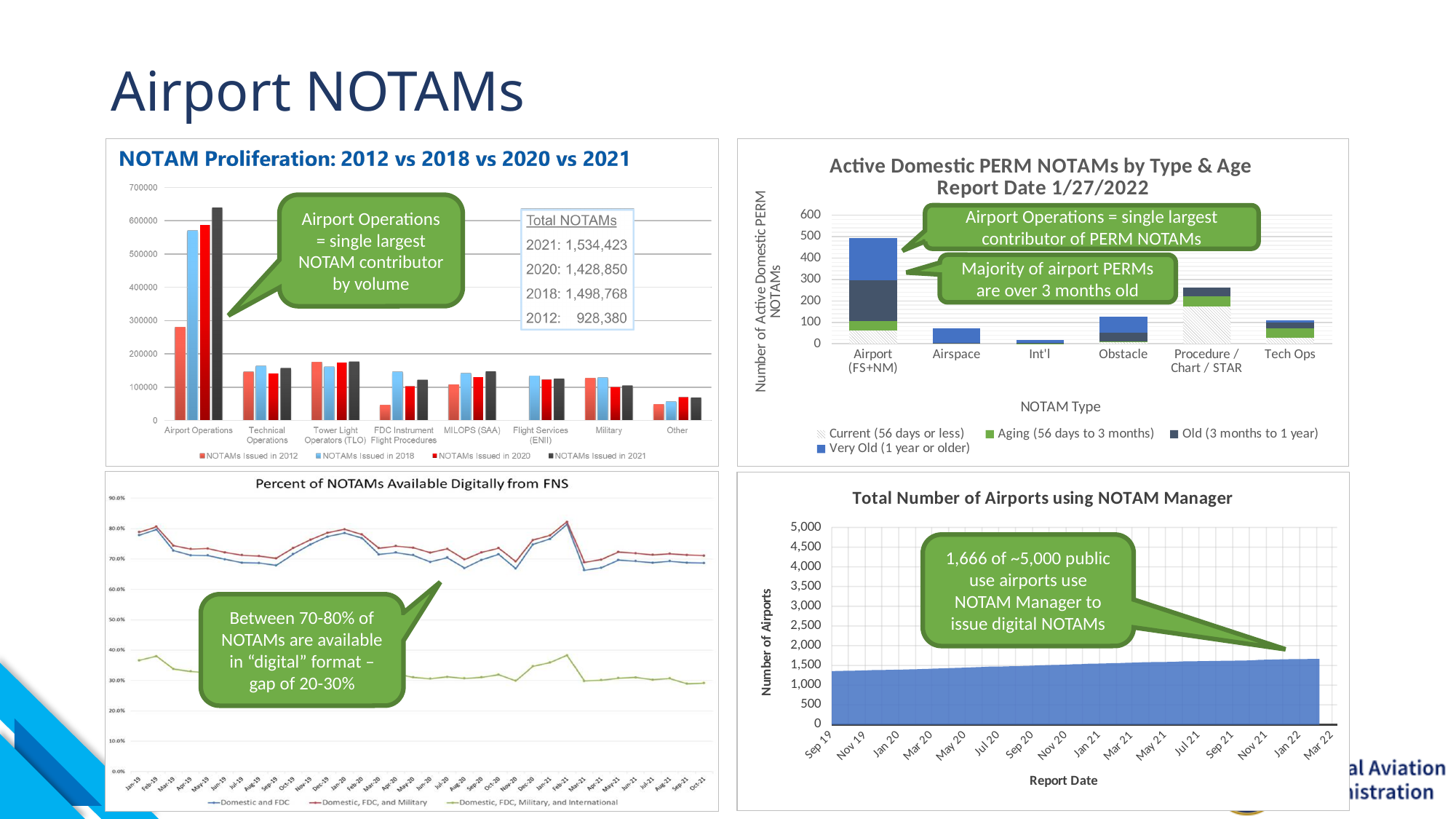
In the 'NOTAM Proliferation' chart, is the value for NOTAMs Issued in 2021 for Airport Operations greater or less than 600000? greater What kind of chart is 'Percent of NOTAMs Available Digitally from FNS'? Line chart In the 'NOTAM Proliferation' chart, what is the Total NOTAMs figure given for 2021? 1,534,423 In the 'Active Domestic PERM NOTAMs by Type & Age' chart, which NOTAM Type has the tallest stacked bar? Airport (FS+NM) In the 'Active Domestic PERM NOTAMs by Type & Age' chart, which NOTAM Type has the shortest stacked bar? Int'l In the 'NOTAM Proliferation' chart, what is the Total NOTAMs figure given for 2012? 928,380 In the 'NOTAM Proliferation: 2012 vs 2018 vs 2020 vs 2021' chart, which category has the highest bars? Airport Operations In the 'Total Number of Airports using NOTAM Manager' chart, do the values rise or fall from Sep 19 to Jan 22? Rise In the 'NOTAM Proliferation' chart, how many series does the legend list? 4 In the 'NOTAM Proliferation' chart, how many categories are shown on the x axis? 8 In the 'Percent of NOTAMs Available Digitally from FNS' chart, how many series does the legend list? 3 In the 'Active Domestic PERM NOTAMs by Type & Age' chart, is the total for Airport (FS+NM) greater or less than 400? greater